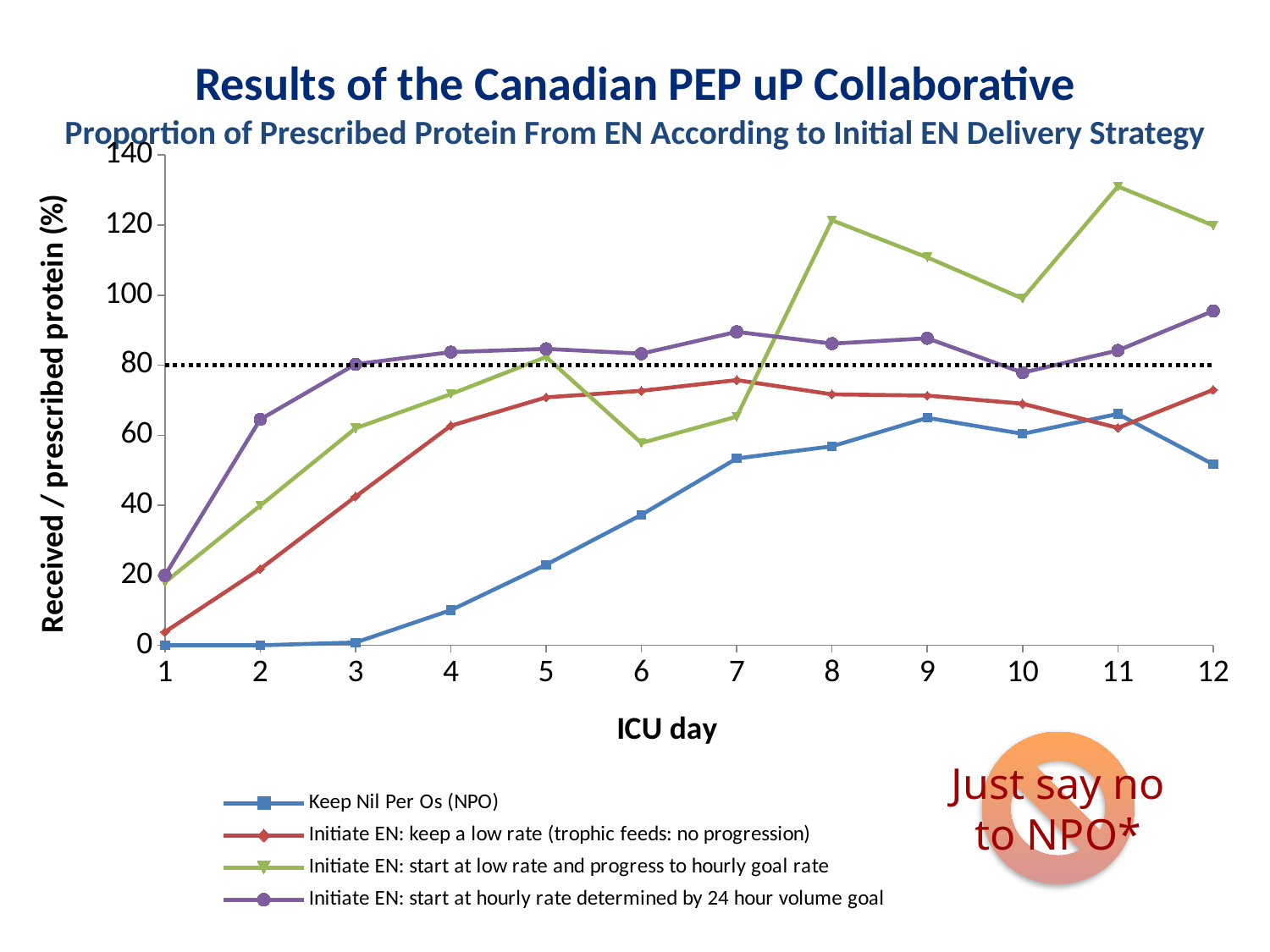
What is the value for Keep Nil Per Os (NPO) on ICU day 1? 0 Is the value for Keep Nil Per Os (NPO) on ICU day 7 greater or less than 40? greater How many ICU days are plotted along the x axis? 12 Which series has the highest value on ICU day 11? Initiate EN: start at low rate and progress to hourly goal rate Which series has the lowest value on ICU day 5? Keep Nil Per Os (NPO) Is the value for 'Initiate EN: keep a low rate (trophic feeds: no progression)' on ICU day 3 greater or less than 60? less On ICU day 12, which is larger: the value for 'Initiate EN: start at hourly rate determined by 24 hour volume goal' or the value for 'Initiate EN: keep a low rate (trophic feeds: no progression)'? Initiate EN: start at hourly rate determined by 24 hour volume goal Is the value for 'Initiate EN: start at low rate and progress to hourly goal rate' on ICU day 8 greater or less than 100? greater How many series does the legend list? 4 What kind of chart is shown on the slide? line chart Does the Keep Nil Per Os (NPO) series rise or fall from ICU day 1 to ICU day 9? rise